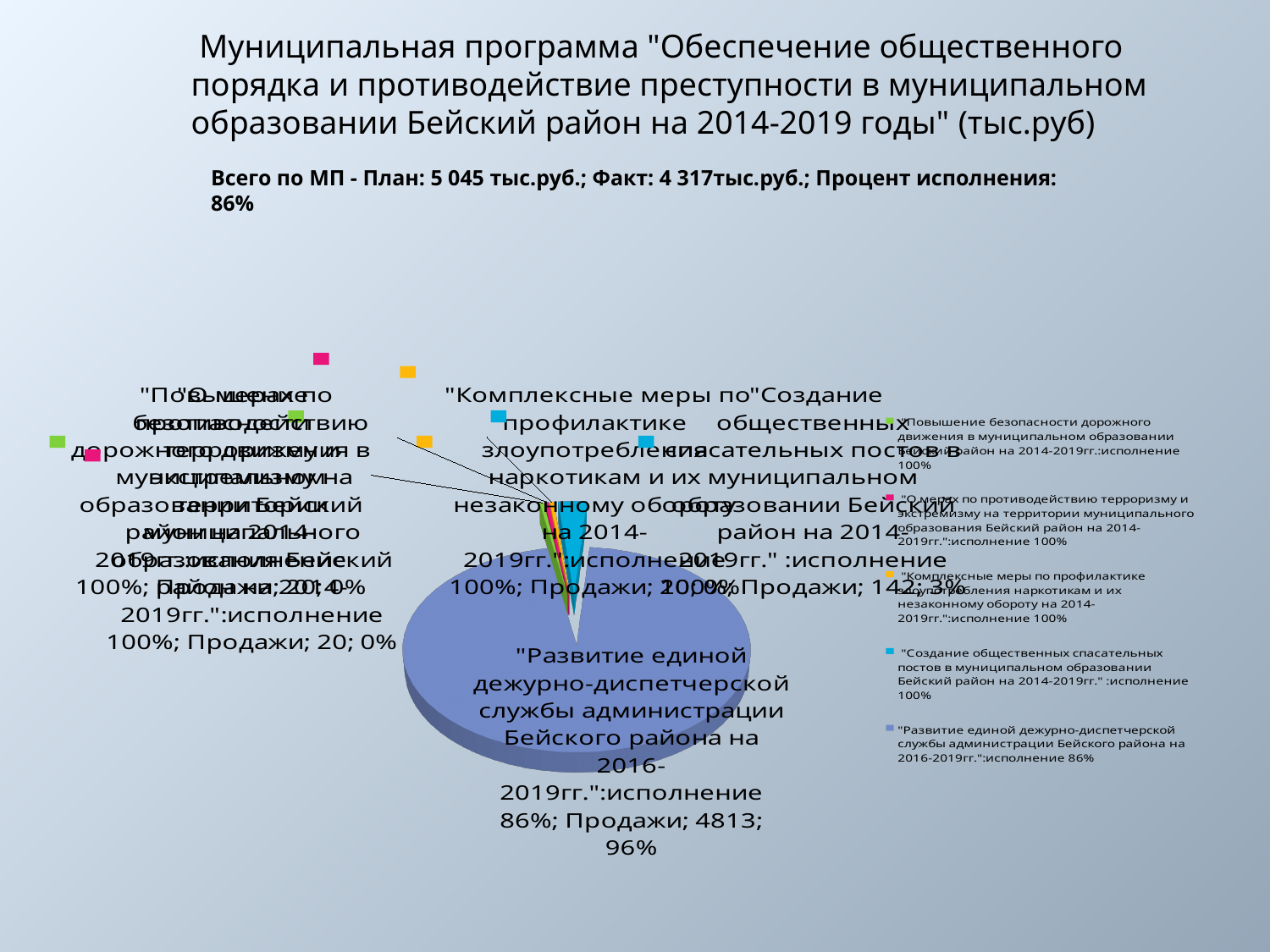
What value is shown for "Развитие единой дежурно-диспетчерской службы администрации Бейского района на 2016-2019гг."? 4813 What share of the pie does "Развитие единой дежурно-диспетчерской службы администрации Бейского района на 2016-2019гг." take? 96% How many slices does the pie chart have? 5 How many entries does the chart legend list? 5 What share of the pie does "Создание общественных спасательных постов в муниципальном образовании Бейский район на 2014-2019гг." take? 3% What value is shown for "Создание общественных спасательных постов в муниципальном образовании Бейский район на 2014-2019гг."? 142 Which is larger: the value for "Развитие единой дежурно-диспетчерской службы" or for "Создание общественных спасательных постов"? "Развитие единой дежурно-диспетчерской службы" Which slice of the pie chart is the largest? "Развитие единой дежурно-диспетчерской службы администрации Бейского района на 2016-2019гг." What kind of chart is shown on the slide? pie chart What value is shown for "Комплексные меры по профилактике злоупотребления наркотикам и их незаконному обороту на 2014-2019гг."? 20 What series name appears in the data labels of the pie chart? Продажи What is the difference between the value for "Развитие единой дежурно-диспетчерской службы" (4813) and "Создание общественных спасательных постов" (142)? 4671